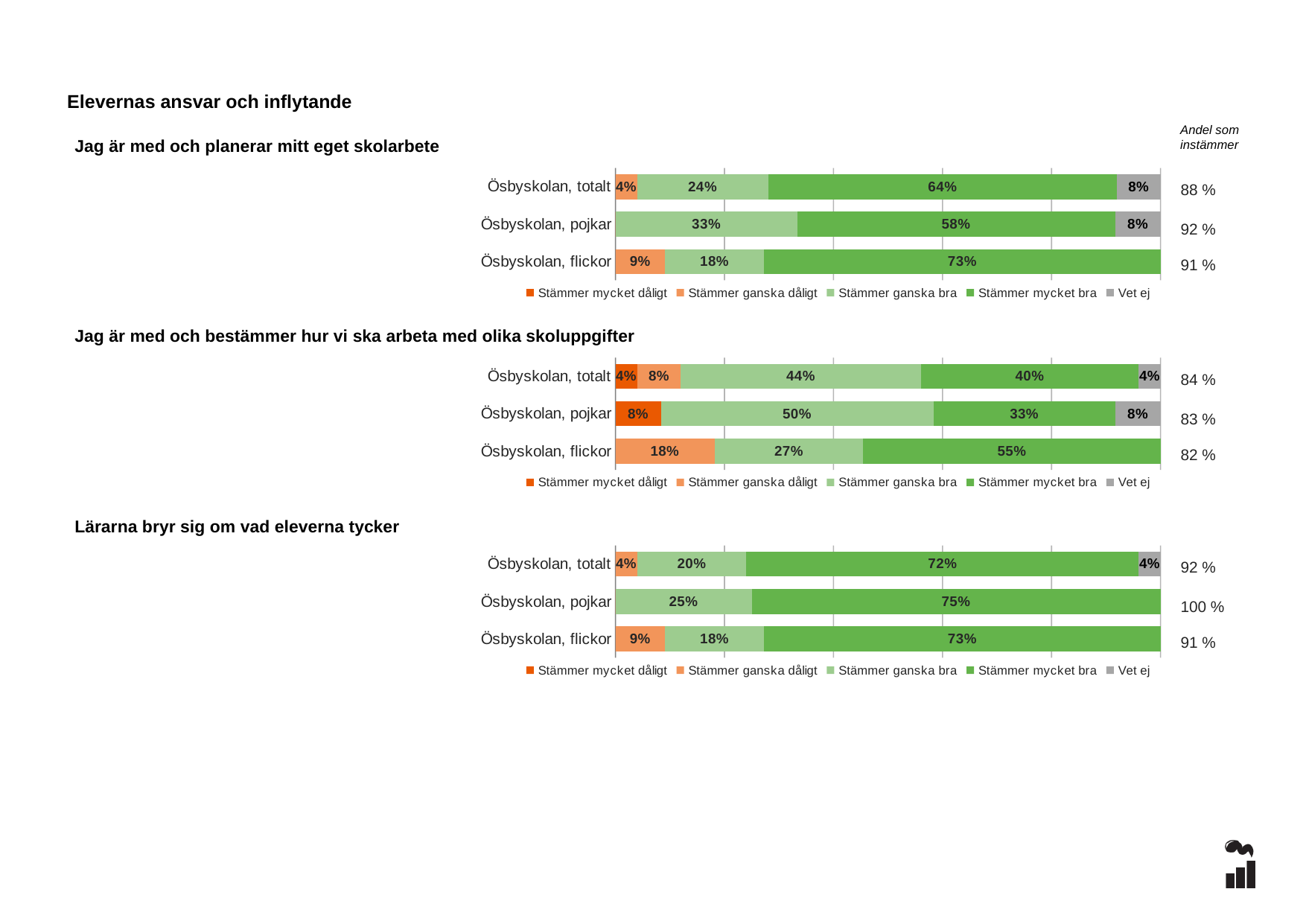
In the chart 'Lärarna bryr sig om vad eleverna tycker', what is the 'Andel som instämmer' value for Ösbyskolan, pojkar? 100 % In the chart 'Jag är med och planerar mitt eget skolarbete', which category has the highest 'Stämmer mycket bra' value? Ösbyskolan, flickor In the chart 'Jag är med och bestämmer hur vi ska arbeta med olika skoluppgifter', what is the 'Stämmer ganska dåligt' value for Ösbyskolan, flickor? 18% How many series does the legend list for the chart 'Lärarna bryr sig om vad eleverna tycker'? 5 In the chart 'Lärarna bryr sig om vad eleverna tycker', which category has the lowest 'Stämmer mycket bra' value? Ösbyskolan, totalt What kind of chart is 'Jag är med och planerar mitt eget skolarbete'? Stacked bar chart In the chart 'Jag är med och bestämmer hur vi ska arbeta med olika skoluppgifter', what is the difference between the 'Stämmer ganska bra' values for Ösbyskolan, pojkar and Ösbyskolan, flickor? 23% In the chart 'Jag är med och planerar mitt eget skolarbete', what is the 'Stämmer mycket bra' value for Ösbyskolan, flickor? 73% In the chart 'Jag är med och bestämmer hur vi ska arbeta med olika skoluppgifter', what is the 'Stämmer mycket dåligt' value for Ösbyskolan, pojkar? 8% In the chart 'Jag är med och bestämmer hur vi ska arbeta med olika skoluppgifter', which is larger for Ösbyskolan, totalt: 'Stämmer ganska bra' or 'Stämmer mycket bra'? Stämmer ganska bra In the chart 'Jag är med och planerar mitt eget skolarbete', what is the 'Stämmer ganska bra' value for Ösbyskolan, pojkar? 33% In the chart 'Lärarna bryr sig om vad eleverna tycker', what is the 'Stämmer mycket bra' value for Ösbyskolan, pojkar? 75%